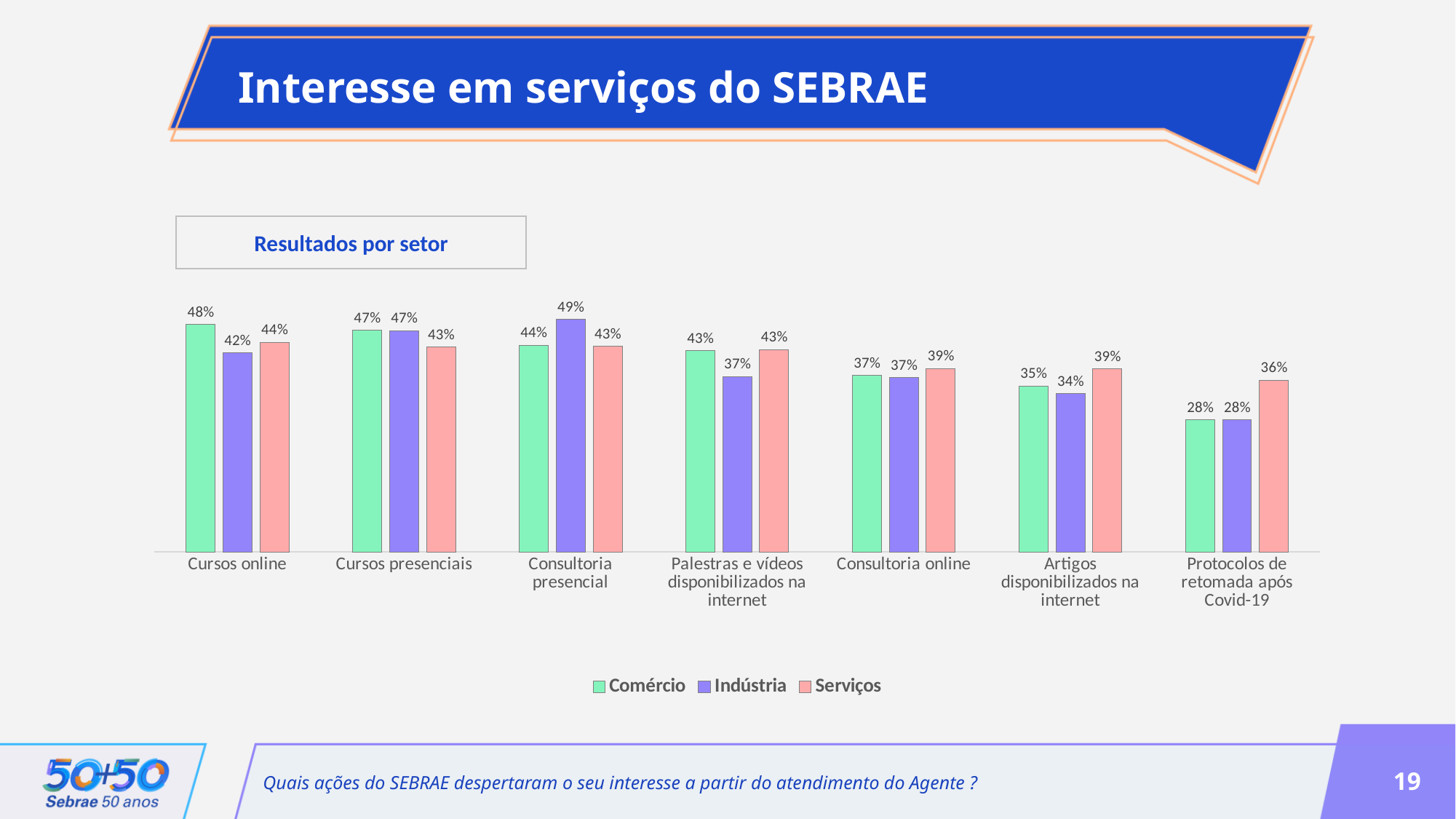
What is the value for Indústria in the Consultoria presencial category? 49% Which category has the highest value for Indústria? Consultoria presencial Do the Serviços values generally rise or fall from Cursos online to Protocolos de retomada após Covid-19? Fall In the Artigos disponibilizados na internet category, which is larger: Serviços or Indústria? Serviços What kind of chart is shown on the slide? Bar chart Which category has the lowest value for Comércio? Protocolos de retomada após Covid-19 What is the value for Serviços in the Protocolos de retomada após Covid-19 category? 36% What is the difference between the Comércio and Indústria values in the Cursos online category? 6% How many series does the legend list? 3 What are the three series listed in the legend? Comércio, Indústria, Serviços How many categories are shown on the x axis? 7 What is the value for Comércio in the Cursos online category? 48%